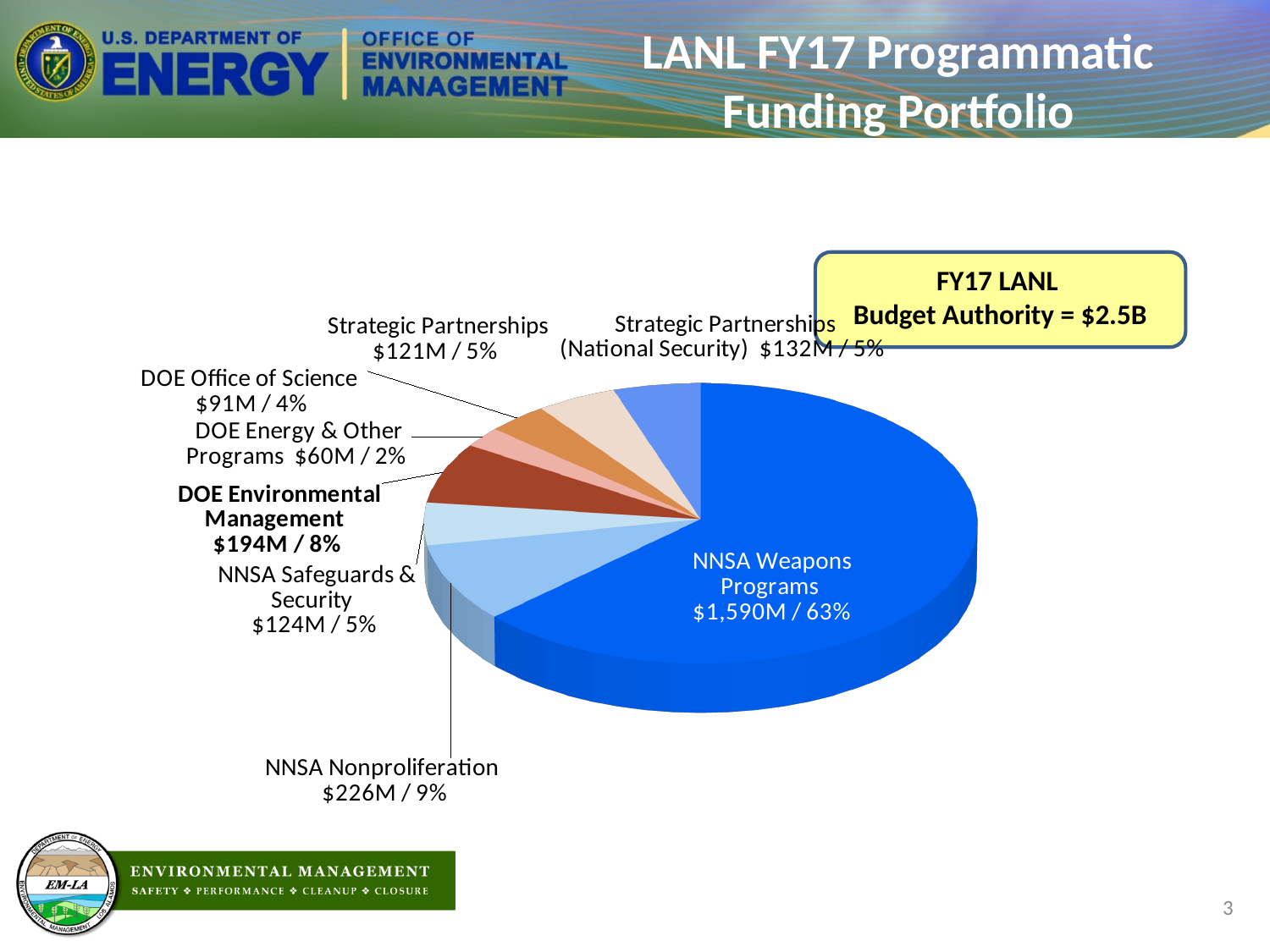
What is the funding value for NNSA Weapons Programs? $1,590M What is the funding value for DOE Environmental Management? $194M Which category has the largest slice of the pie? NNSA Weapons Programs What kind of chart is shown on the slide? pie chart Which is larger, the funding for Strategic Partnerships (National Security) or for NNSA Safeguards & Security? Strategic Partnerships (National Security) How many slices does the pie chart have? 8 What is the funding value for DOE Energy & Other Programs? $60M What is the funding value for NNSA Nonproliferation? $226M What share of the pie does DOE Office of Science represent? 4% What share of the pie does NNSA Weapons Programs represent? 63% What is the difference in funding between NNSA Nonproliferation and DOE Environmental Management? $32M Which category has the smallest slice of the pie? DOE Energy & Other Programs